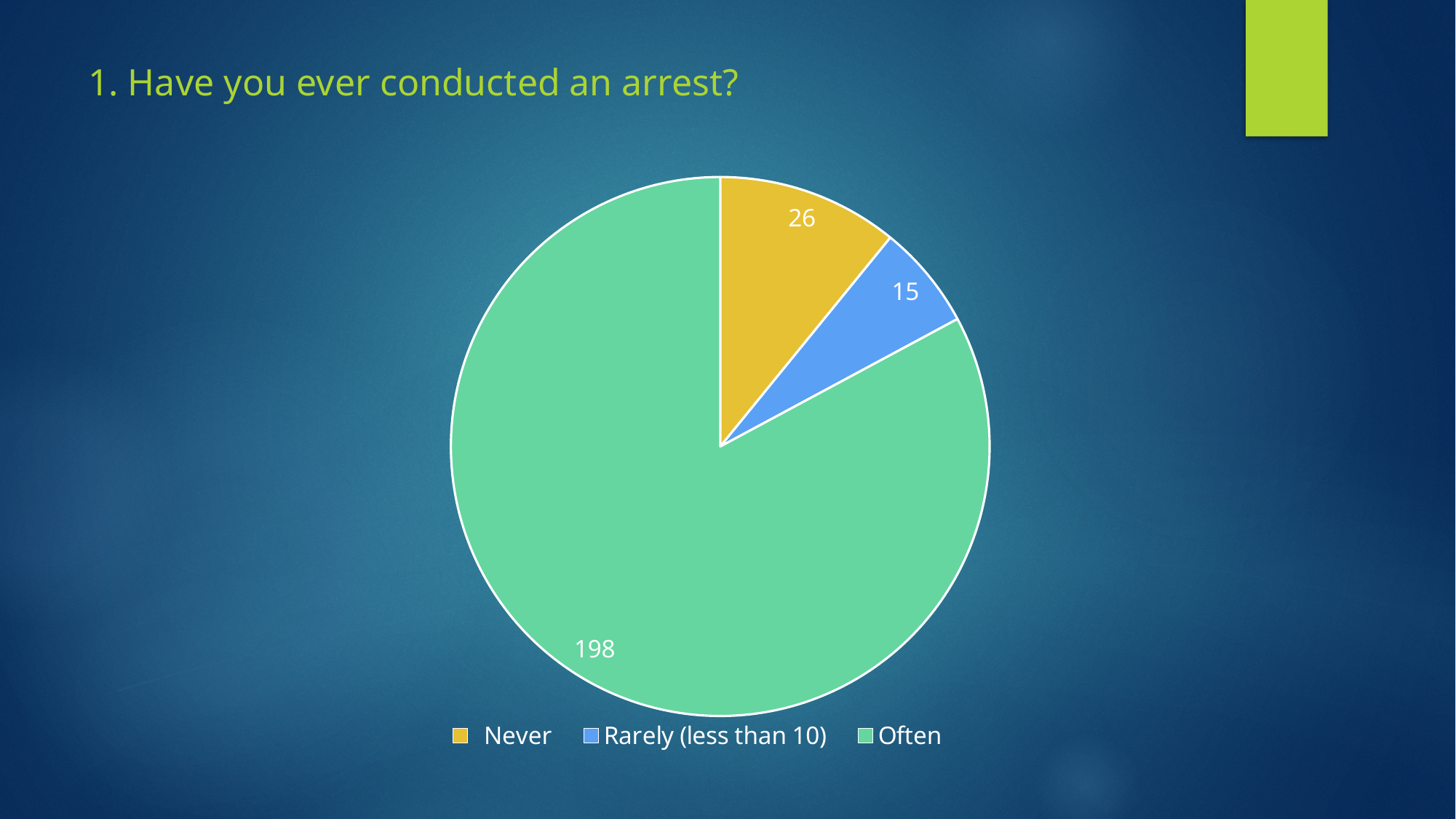
Which category has the largest slice? Often What is the difference between the values for Often and Never? 172 Which is larger, the value for Never or the value for Rarely (less than 10)? Never Which category has the smallest slice? Rarely (less than 10) What is the total of all slices in the pie chart? 239 What kind of chart is shown on the slide? Pie chart What is the title of the chart? 1. Have you ever conducted an arrest? How many categories does the pie chart show? 3 What is the value for Rarely (less than 10)? 15 What is the value for Often? 198 What is the difference between the values for Never and Rarely (less than 10)? 11 What is the value for Never? 26